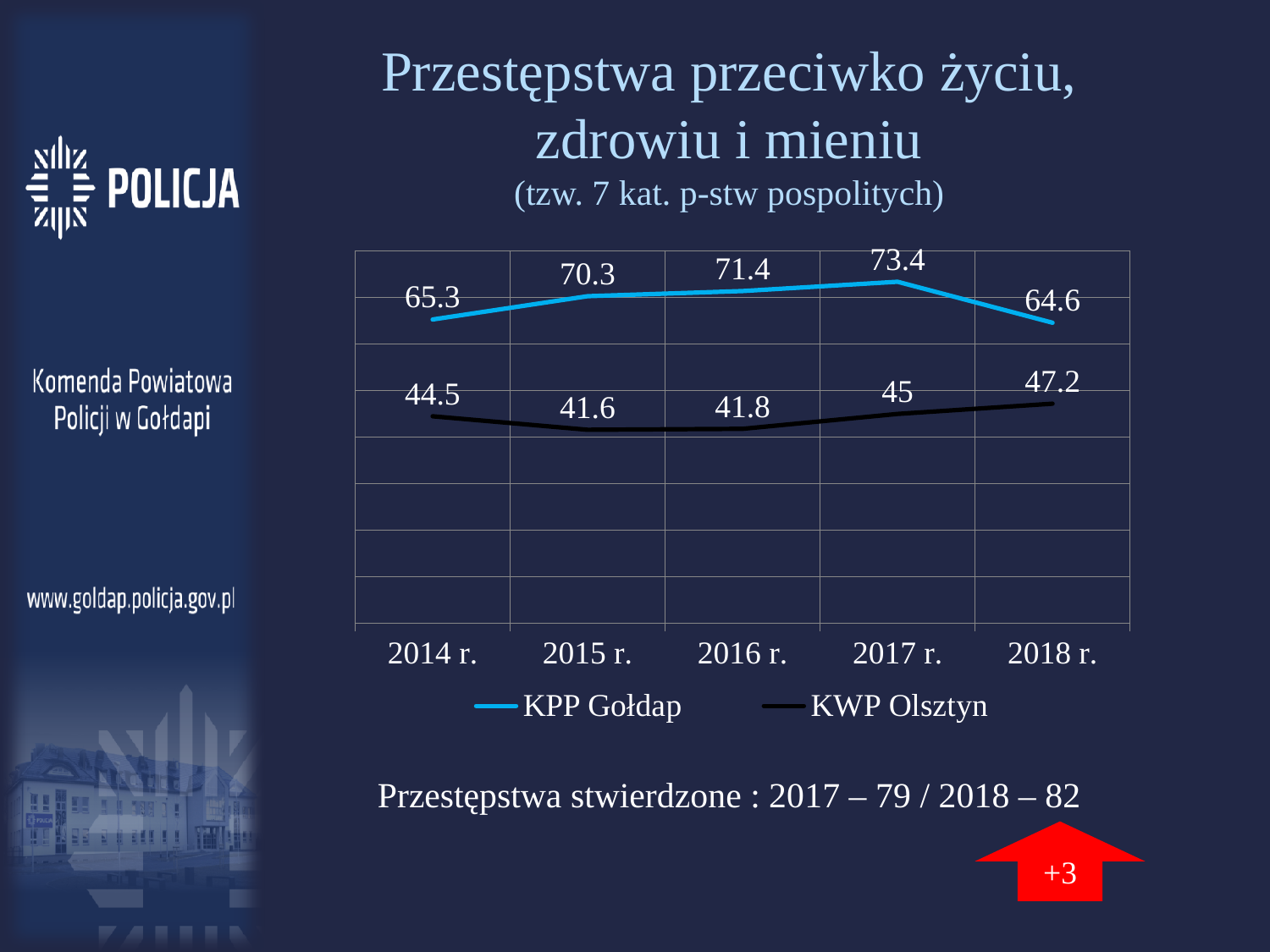
What is the value for KPP Gołdap in 2017 r.? 73.4 In which year is the KWP Olsztyn value lowest? 2015 r. In which year is the KPP Gołdap value highest? 2017 r. Does the KWP Olsztyn value rise or fall from 2016 r. to 2018 r.? Rise Which series has the larger value in 2016 r., KPP Gołdap or KWP Olsztyn? KPP Gołdap What is the difference between the KPP Gołdap and KWP Olsztyn values in 2014 r.? 20.8 What kind of chart is shown on the slide? Line chart Which colour is used for the KPP Gołdap line? Blue What is the value for KPP Gołdap in 2018 r.? 64.6 How many years are shown on the x axis? 5 What is the value for KWP Olsztyn in 2015 r.? 41.6 How many series does the legend list? 2